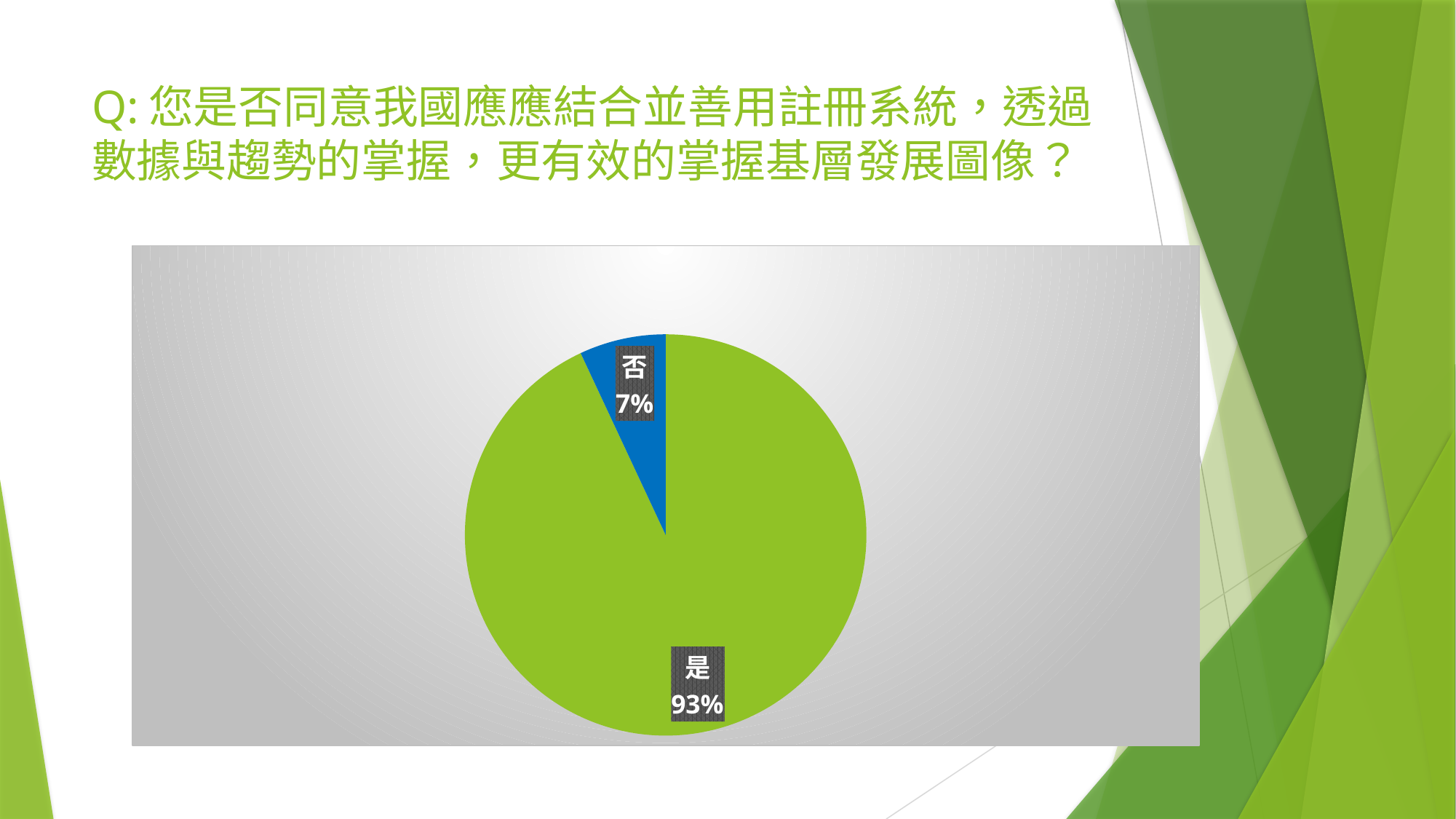
What is the difference in percentage points between the 是 slice and the 否 slice? 86 Which slice of the pie is the smallest? 否 What share of the pie does the 否 slice represent? 7% Which slice of the pie is the largest? 是 How many slices does the pie chart have? 2 What percentage of the pie is labelled 否? 7% What kind of chart is shown on the slide? pie chart Which slice is larger, 是 or 否? 是 What percentage of the pie is labelled 是? 93% What colour is the 是 slice of the pie? green What colour is the 否 slice of the pie? blue